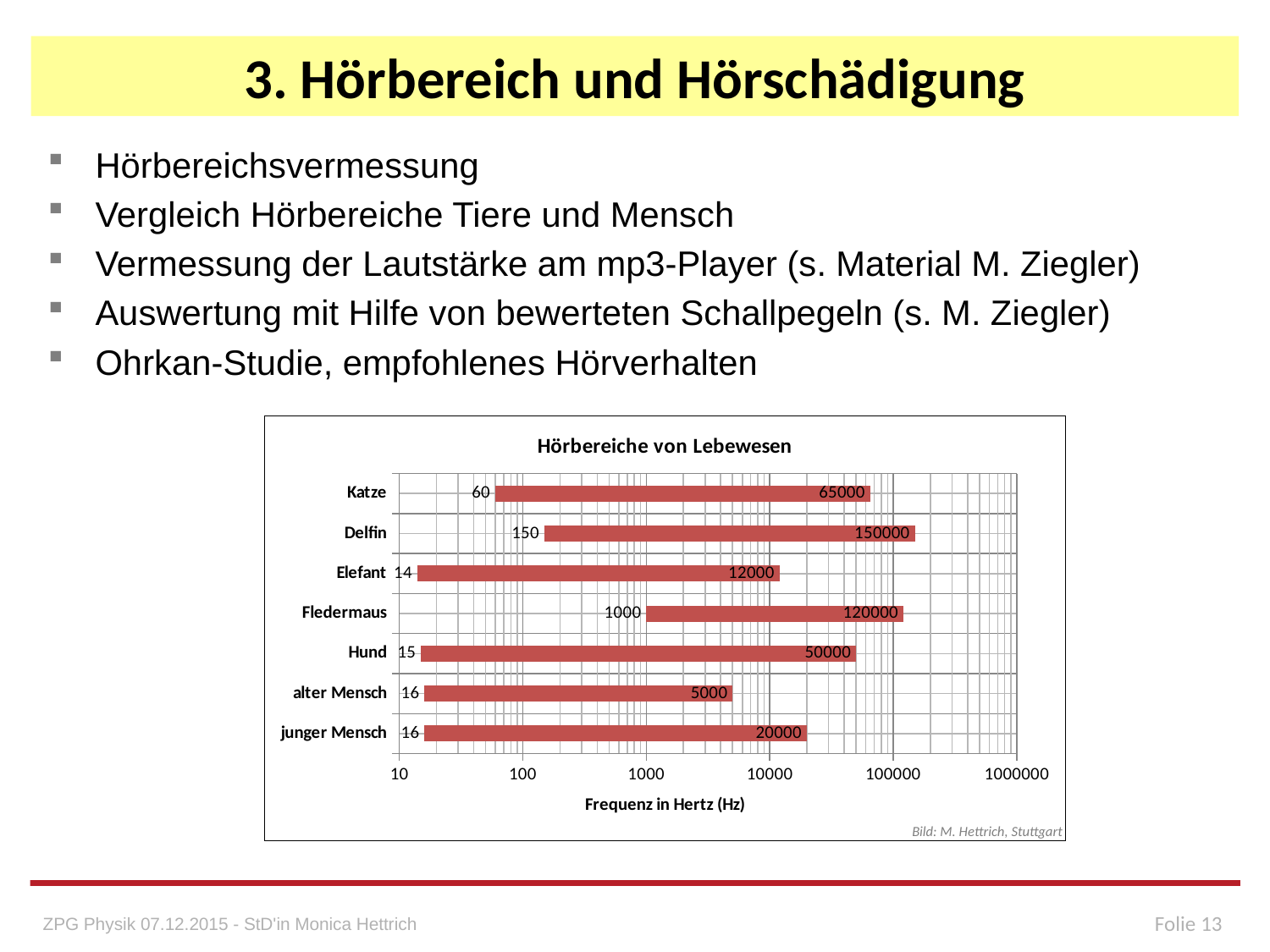
How many living beings are listed in the chart 'Hörbereiche von Lebewesen'? 7 In the chart 'Hörbereiche von Lebewesen', which living being has the highest lower hearing limit? Fledermaus What is the x-axis label of the chart 'Hörbereiche von Lebewesen'? Frequenz in Hertz (Hz) In the chart 'Hörbereiche von Lebewesen', which living being has the highest upper hearing limit? Delfin In the chart 'Hörbereiche von Lebewesen', what is the upper hearing limit shown for alter Mensch? 5000 In the chart 'Hörbereiche von Lebewesen', which living being has the lowest upper hearing limit? alter Mensch In the chart 'Hörbereiche von Lebewesen', what is the lower hearing limit shown for Fledermaus? 1000 What kind of chart is 'Hörbereiche von Lebewesen'? bar chart In the chart 'Hörbereiche von Lebewesen', what is the lower hearing limit shown for Elefant? 14 In the chart 'Hörbereiche von Lebewesen', what is the difference between the upper hearing limits of junger Mensch and alter Mensch? 15000 In the chart 'Hörbereiche von Lebewesen', what is the upper hearing limit shown for Katze? 65000 In the chart 'Hörbereiche von Lebewesen', which has the higher upper hearing limit, Hund or Katze? Katze